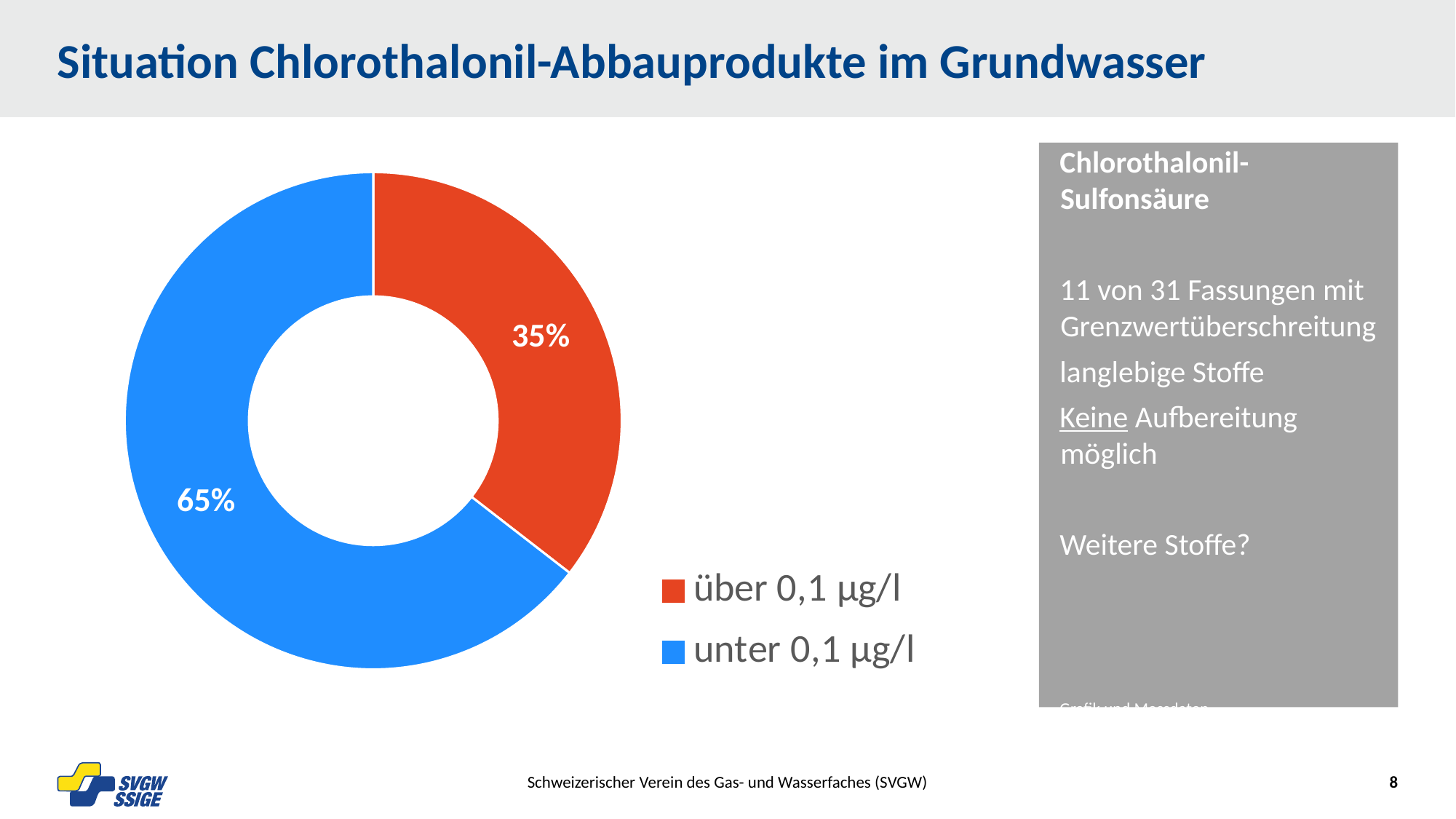
Which slice is the smallest in the chart? über 0,1 µg/l How many entries does the legend list? 2 What is the difference in percentage points between the 'unter 0,1 µg/l' and 'über 0,1 µg/l' slices? 30 percentage points What share of the pie does the slice 'über 0,1 µg/l' represent? 35% What kind of chart is shown on the slide? Pie chart (doughnut) Which is larger: the share for 'über 0,1 µg/l' or the share for 'unter 0,1 µg/l'? unter 0,1 µg/l What share of the pie does the slice 'unter 0,1 µg/l' represent? 65% How many slices does the chart have? 2 What colour is the slice for 'über 0,1 µg/l'? Red What colour is the slice for 'unter 0,1 µg/l'? Blue Which slice is the largest in the chart? unter 0,1 µg/l